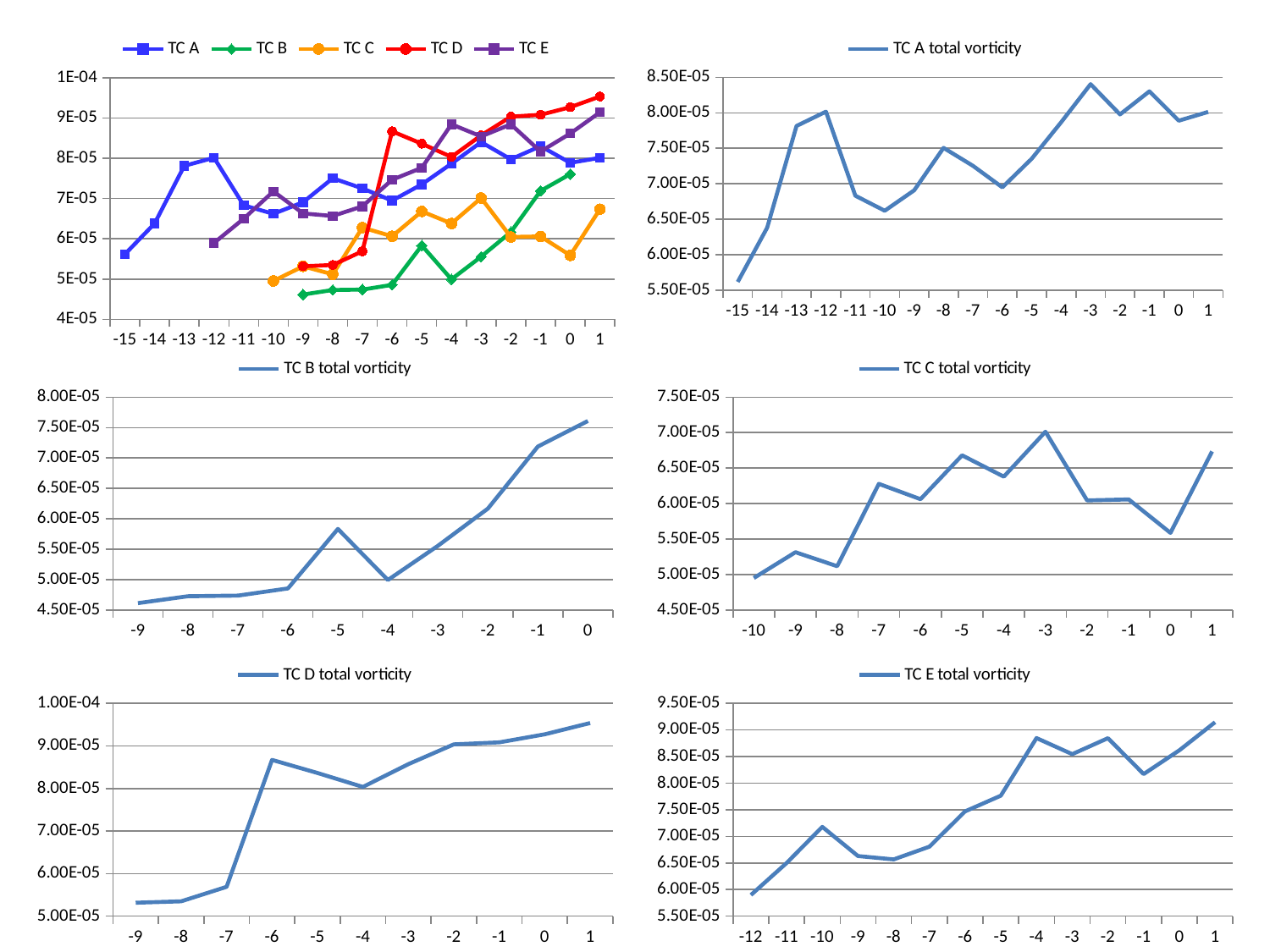
In the top-left chart, which series has the highest value at x = 1? TC D In the 'TC B total vorticity' chart, at which x value is the line highest? 0 In the 'TC C total vorticity' chart, at which x value is the line lowest? -10 In the 'TC B total vorticity' chart, how many points are plotted along the x axis? 10 In the top-left chart, how many series does the legend list? 5 What kind of chart is the 'TC A total vorticity' chart? line chart In the 'TC D total vorticity' chart, which is larger, the value at -7 or the value at -6? -6 In the 'TC E total vorticity' chart, do the values generally rise or fall from -12 to 1? rise In the 'TC D total vorticity' chart, is the value at -6 greater or less than 8.00E-05? greater In the 'TC E total vorticity' chart, how many points are plotted along the x axis? 14 In the 'TC A total vorticity' chart, is the value at -15 greater or less than 6.00E-05? less In the 'TC C total vorticity' chart, how many points are plotted along the x axis? 12